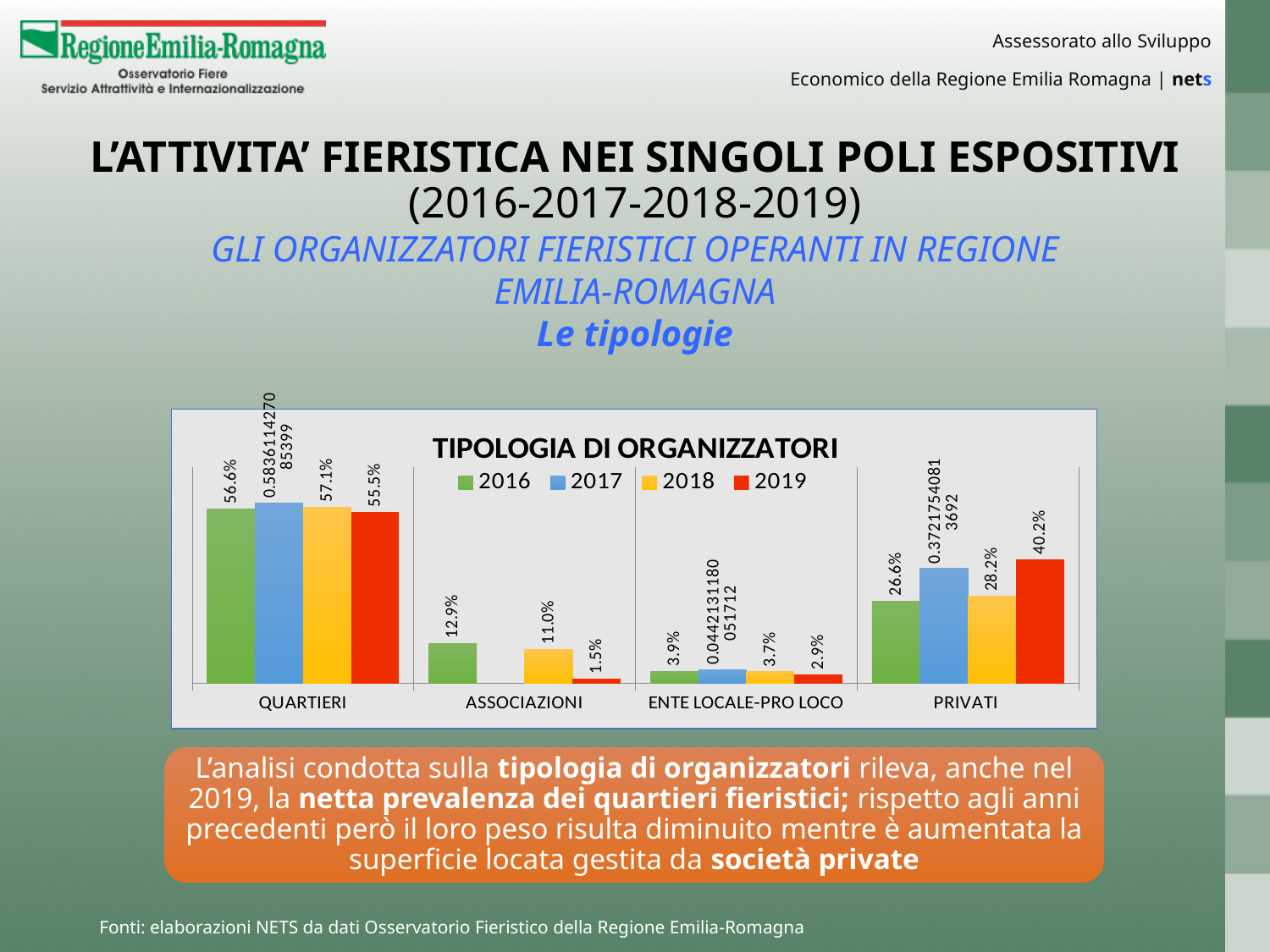
In the TIPOLOGIA DI ORGANIZZATORI chart, what is the value for PRIVATI in 2019? 40.2% In the TIPOLOGIA DI ORGANIZZATORI chart, which is larger for QUARTIERI: the 2016 value or the 2018 value? 2018 In the TIPOLOGIA DI ORGANIZZATORI chart, which category has the lowest value in 2019? ASSOCIAZIONI In the TIPOLOGIA DI ORGANIZZATORI chart, which category has the highest value in 2019? QUARTIERI In the TIPOLOGIA DI ORGANIZZATORI chart, what is the value for ASSOCIAZIONI in 2016? 12.9% How many series does the legend of the TIPOLOGIA DI ORGANIZZATORI chart list? 4 How many categories are shown on the x axis of the TIPOLOGIA DI ORGANIZZATORI chart? 4 In the TIPOLOGIA DI ORGANIZZATORI chart, what is the value for ENTE LOCALE-PRO LOCO in 2018? 3.7% In the TIPOLOGIA DI ORGANIZZATORI chart, does the ASSOCIAZIONI value rise or fall from 2016 to 2019? Fall In the TIPOLOGIA DI ORGANIZZATORI chart, by how much did the PRIVATI value increase from 2018 to 2019? 12.0 percentage points In the TIPOLOGIA DI ORGANIZZATORI chart, what is the value for QUARTIERI in 2019? 55.5% What kind of chart is the TIPOLOGIA DI ORGANIZZATORI chart? Bar chart